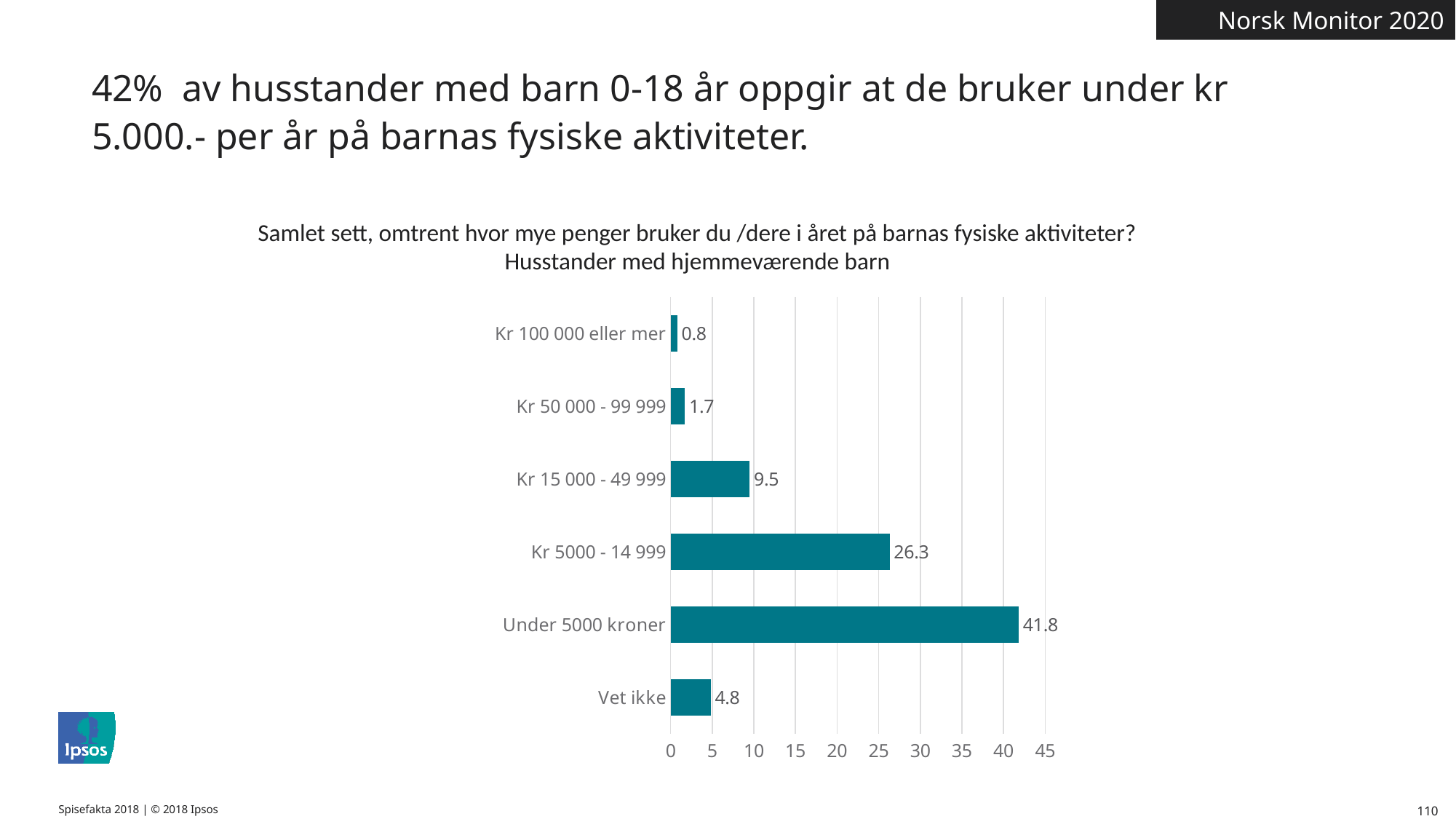
What is the value for "Kr 5000 - 14 999"? 26.3 What kind of chart is shown on the slide? Bar chart Is the value for "Kr 5000 - 14 999" greater or less than 25? greater What is the highest tick value shown on the horizontal axis? 45 What is the value for "Kr 15 000 - 49 999"? 9.5 Which category has the lowest value? Kr 100 000 eller mer How many categories are shown in the chart? 6 Which is larger, the value for "Kr 50 000 - 99 999" or the value for "Vet ikke"? Vet ikke What is the value for "Vet ikke"? 4.8 Which category has the highest value? Under 5000 kroner What is the value for "Under 5000 kroner"? 41.8 What is the difference between the values for "Under 5000 kroner" and "Kr 5000 - 14 999"? 15.5